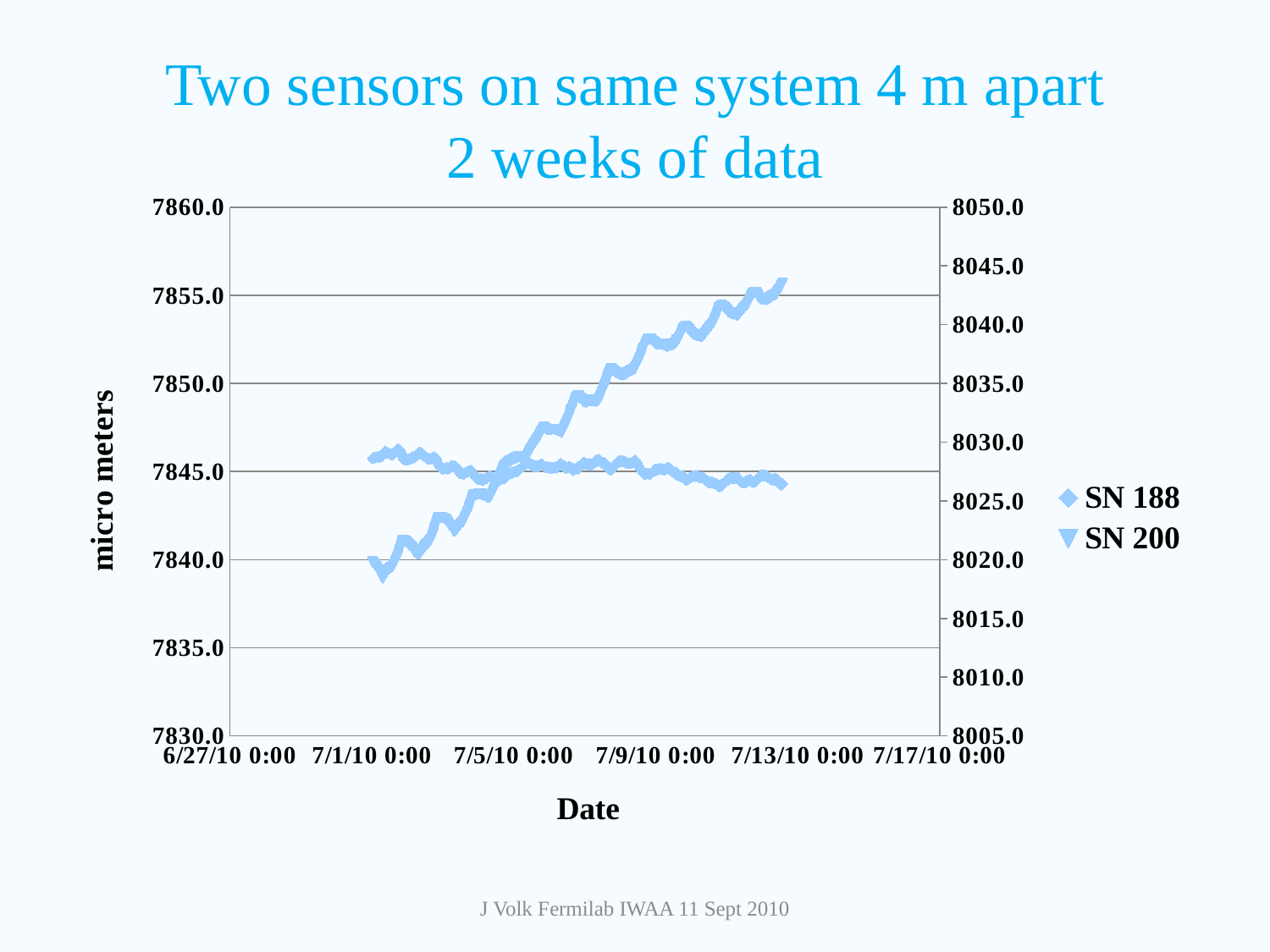
Which series reaches the highest point on the chart? SN 200 Which series is plotted lower on the chart at the end of the period, SN 188 or SN 200? SN 188 What are the two series named in the legend? SN 188 and SN 200 Does the SN 200 series rise or fall over the two weeks shown? rises What kind of chart is shown on the slide? scatter chart How many date labels are shown along the x axis? 6 What is the title of the x axis? Date Which series shows the larger change over the two weeks, SN 188 or SN 200? SN 200 Does the SN 188 series show a strong rise, a strong fall, or stay roughly flat over the period? roughly flat How many series does the legend list? 2